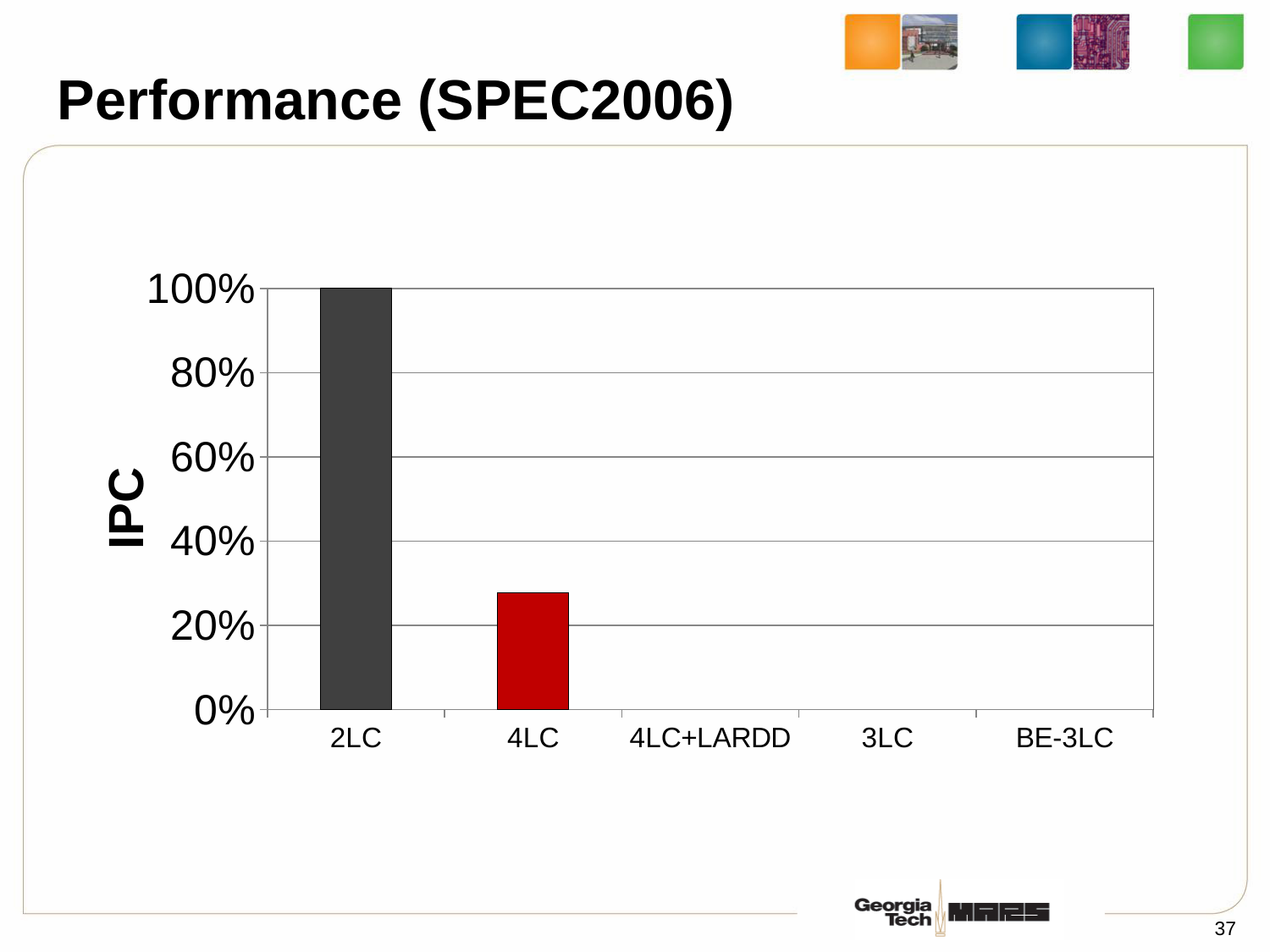
Which category has the tallest bar in the chart? 2LC Which has the higher IPC, 2LC or 4LC? 2LC Does the IPC value rise or fall from 2LC to 4LC? Fall What is the IPC value shown for 2LC? 100% Is the value for 4LC greater or less than 40%? less What colour is the bar for 4LC? Red How many categories are labelled on the x axis? 5 What kind of chart is shown on the slide? Bar chart Is the value for 4LC greater or less than 20%? greater What is the label on the y axis of the chart? IPC